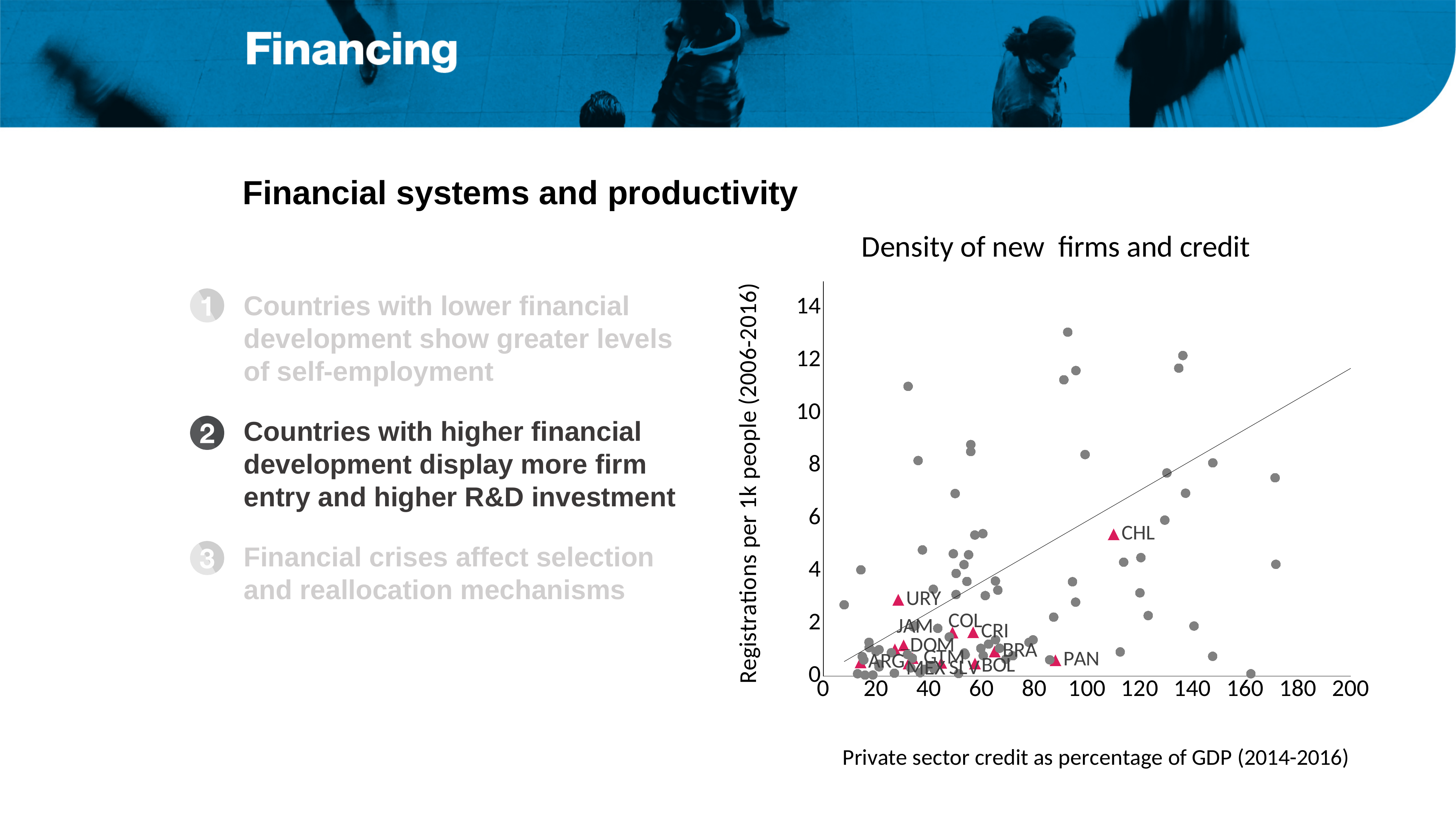
Among the labeled countries, which has the lowest private sector credit as percentage of GDP? ARG What kind of chart is shown on the slide? scatter chart Is the registrations per 1k people value for CHL greater or less than 6? less Is the private sector credit value for PAN greater or less than 100? less Is the private sector credit value for ARG greater or less than 40? less What is the title of the chart? Density of new firms and credit Among the labeled countries, which has the highest registrations per 1k people? CHL Which has a higher registrations per 1k people value, CHL or URY? CHL How many countries are labeled with a country code on the chart? 13 What is the label of the x axis of the chart? Private sector credit as percentage of GDP (2014-2016)